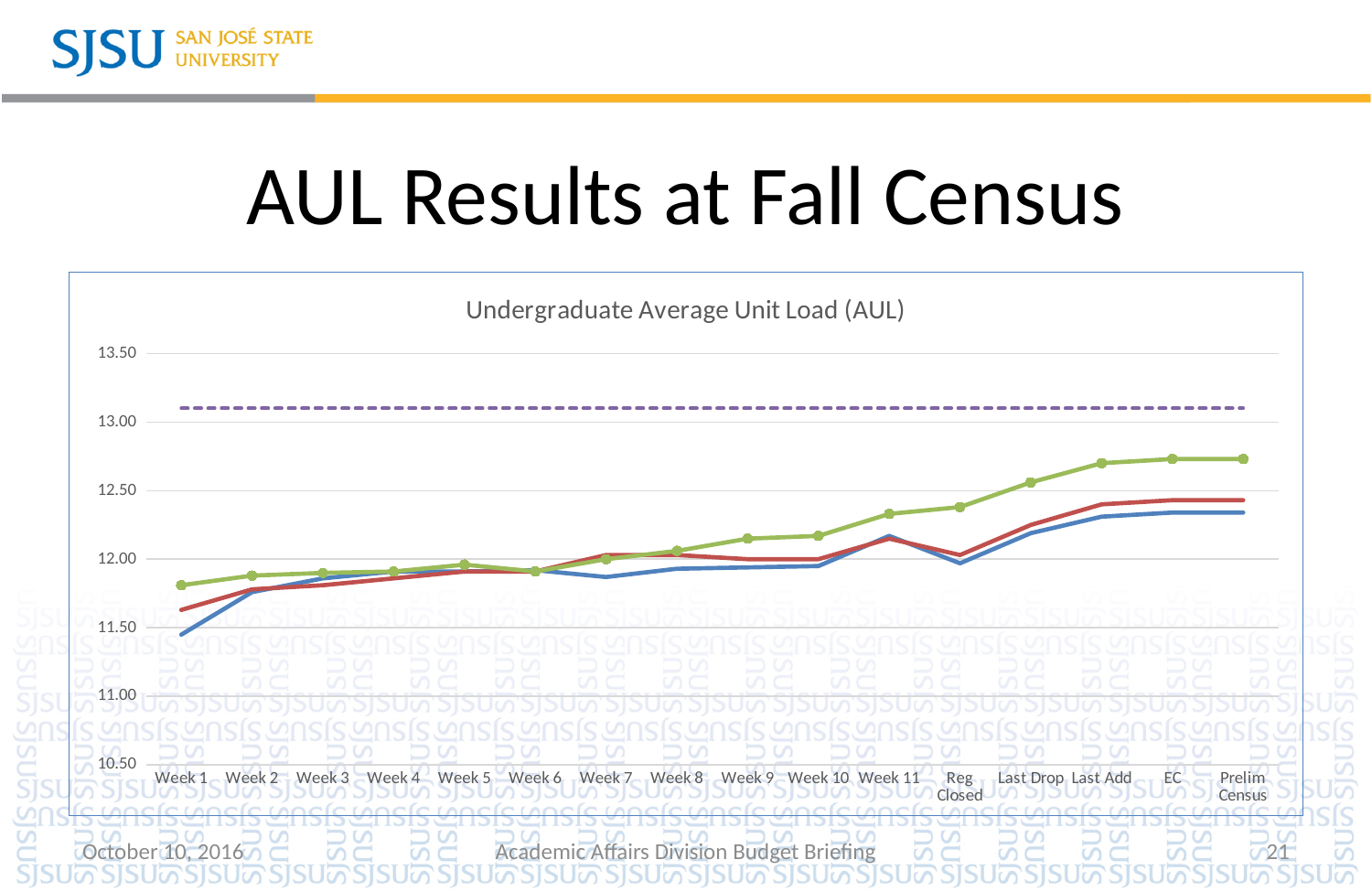
At Last Add, is the green line or the blue line higher? the green line Does the green line generally rise or fall from Week 1 to Prelim Census? rise Is the value of the green line at Prelim Census greater or less than 12.50? greater What kind of chart is shown on the slide? line chart Is the value of the dashed purple line greater or less than 13.00? greater Is the value of the green line at Week 1 greater or less than 12.00? less What is the label of the last category on the x axis? Prelim Census What is the title of the chart? Undergraduate Average Unit Load (AUL) How many categories are shown along the x axis of the chart? 16 Which of the solid lines has the highest value at Prelim Census? the green line